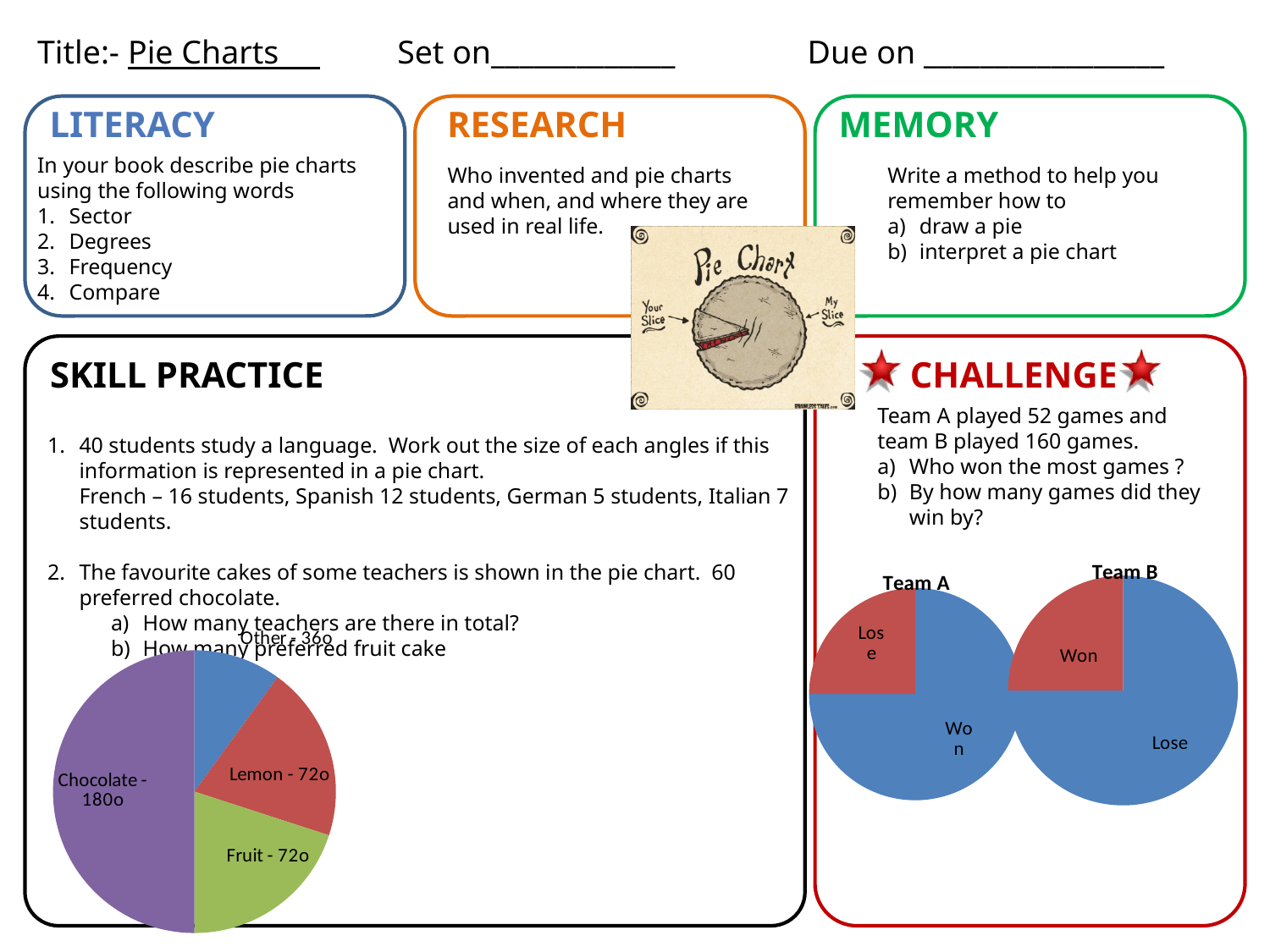
In the Team A pie chart, which slice is larger, Won or Lose? Won In the favourite cakes pie chart, how many slices are there? 4 In the favourite cakes pie chart, which category has the smallest slice? Other In the Team B pie chart, which slice is larger, Won or Lose? Lose In the favourite cakes pie chart, which cake has the largest slice? Chocolate In the favourite cakes pie chart, what angle is shown for Lemon? 72o In the favourite cakes pie chart, what is the difference between the Chocolate angle and the Fruit angle? 108o In the favourite cakes pie chart, what angle is shown for Other? 36o What kind of chart is used to show the favourite cakes of the teachers? Pie chart In the favourite cakes pie chart, what share of the whole pie does Chocolate take? 50% In the Team A pie chart, what colour is the Lose slice? Red In the favourite cakes pie chart, what angle is shown for Chocolate? 180o